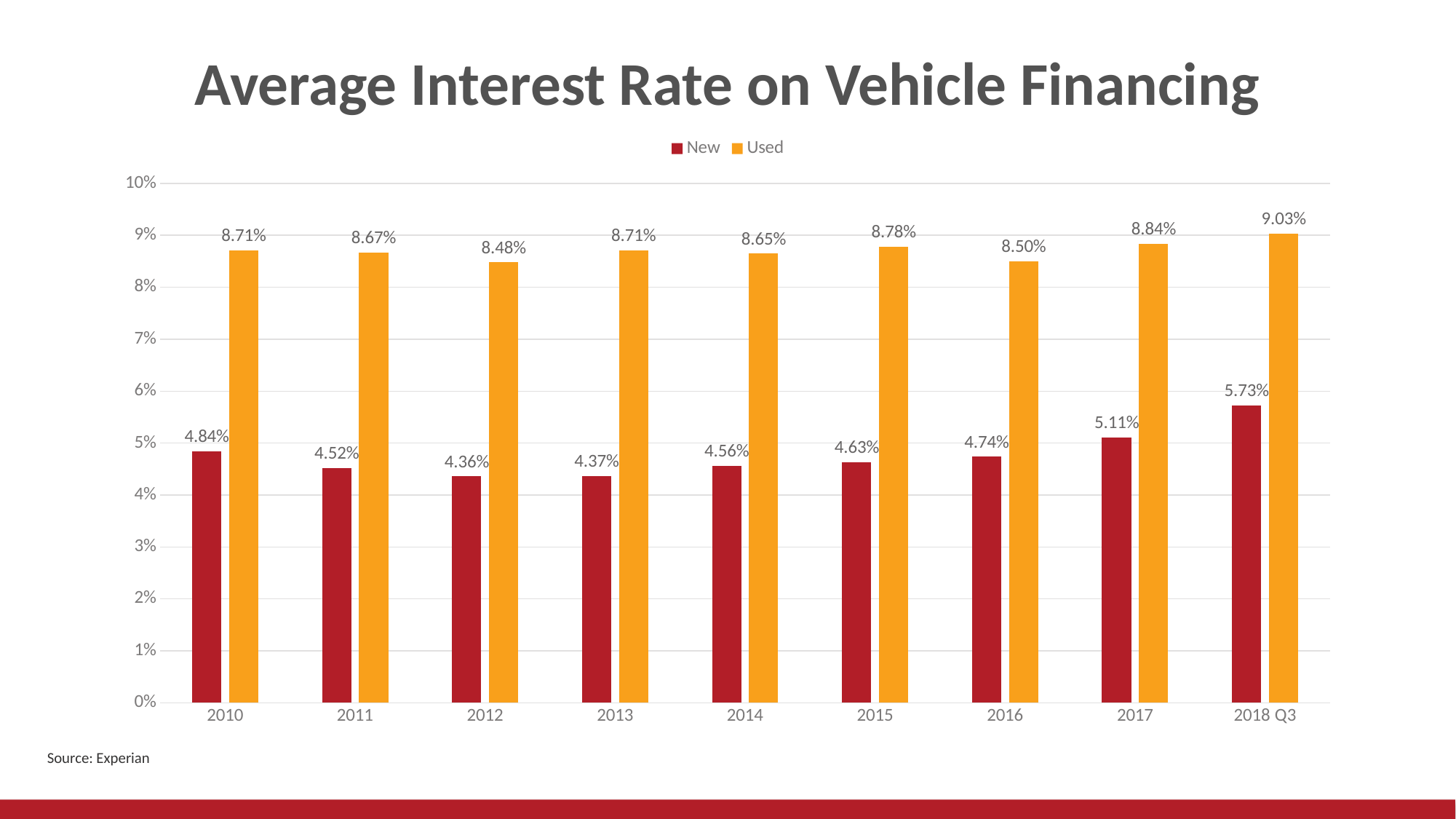
What is the average interest rate for New vehicle financing in 2010? 4.84% In which period is the Used vehicle interest rate highest? 2018 Q3 How many series does the legend list? 2 In which year is the New vehicle interest rate lowest? 2012 What is the Used vehicle interest rate in 2016? 8.50% What is the difference between the Used and New interest rates in 2017? 3.73% What is the average interest rate for Used vehicle financing in 2018 Q3? 9.03% What is the title of the chart? Average Interest Rate on Vehicle Financing What kind of chart is shown on the slide? Bar chart How many time periods are shown on the x axis? 9 Which is larger in 2014, the New rate or the Used rate? Used Is the New vehicle interest rate in 2018 Q3 greater or less than 5%? greater